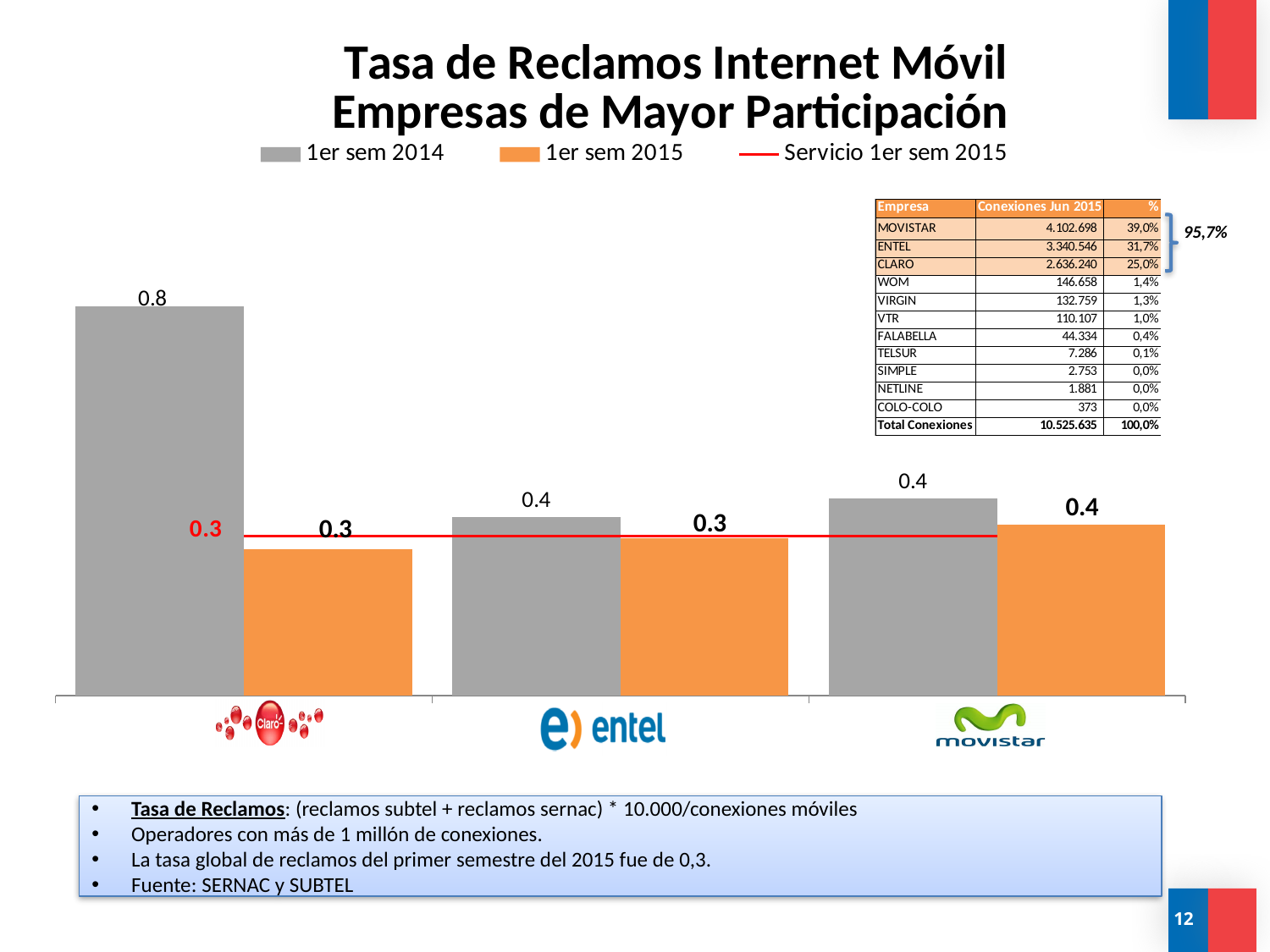
Which is larger for Claro: the 1er sem 2014 value or the 1er sem 2015 value? 1er sem 2014 What is the difference between Claro's 1er sem 2014 value and its 1er sem 2015 value? 0.5 What is the value for Claro in 1er sem 2015? 0.3 What is the value for Entel in 1er sem 2015? 0.3 What value does the red 'Servicio 1er sem 2015' line mark on the chart? 0.3 How many series does the chart legend list? 3 How many companies are shown on the x axis of the chart? 3 Which colour represents the 1er sem 2015 series in the chart? orange Which company has the highest value in 1er sem 2014? Claro What is the value for Movistar in 1er sem 2015? 0.4 What kind of chart is shown on the slide? combination bar and line chart What is the value for Claro in 1er sem 2014? 0.8